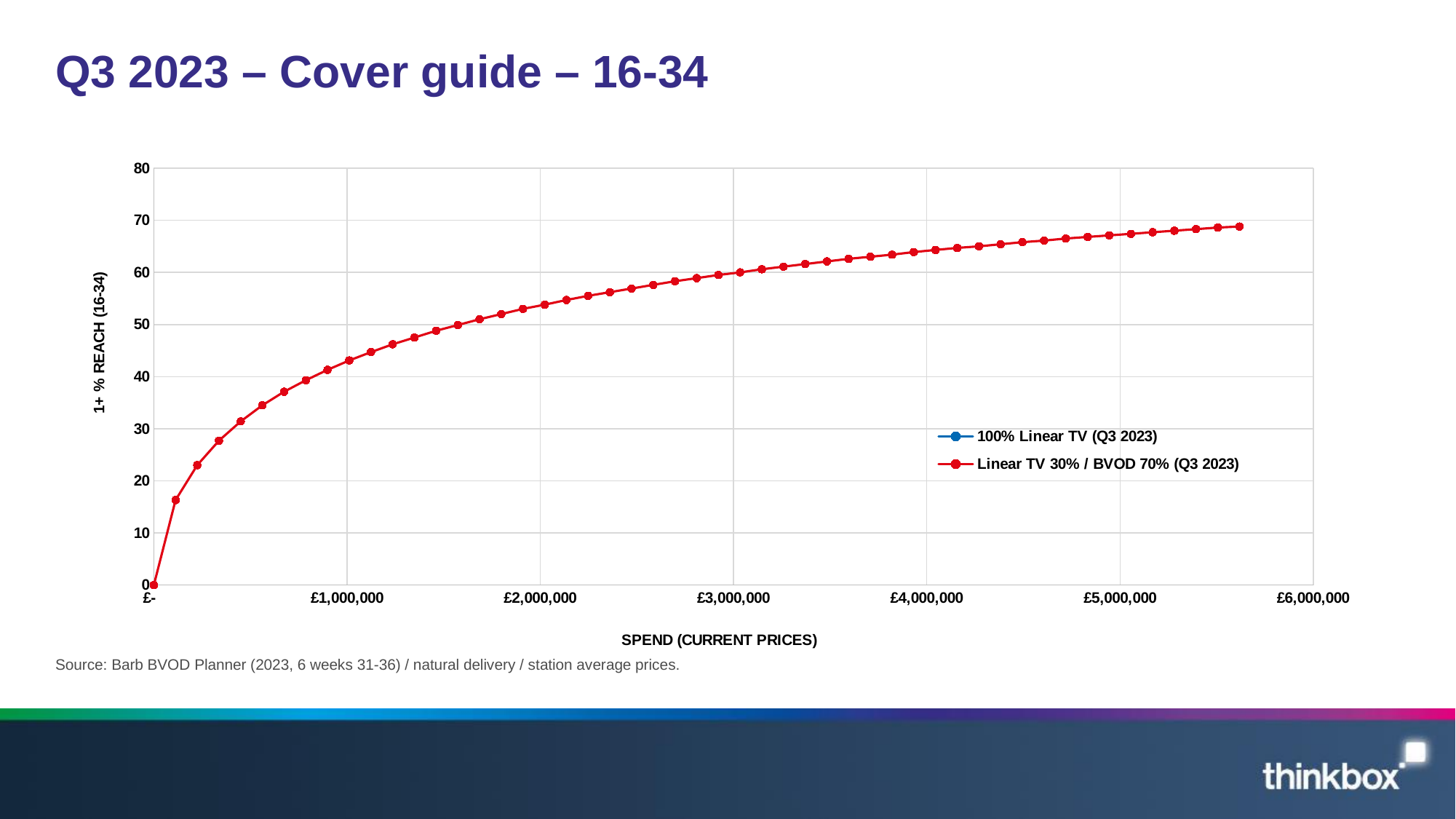
Is the 1+ % reach for the Linear TV 30% / BVOD 70% (Q3 2023) series at a spend of £1,000,000 greater or less than 40? greater What is the title of the y axis? 1+ % REACH (16-34) Does the 1+ % reach rise or fall as spend increases along the x axis? rise Is the 1+ % reach for the Linear TV 30% / BVOD 70% (Q3 2023) series at a spend of £4,000,000 greater or less than 70? less Is the 1+ % reach for the Linear TV 30% / BVOD 70% (Q3 2023) series at a spend of £5,000,000 greater or less than 70? less How many series does the legend list? 2 What colour is the line for the Linear TV 30% / BVOD 70% (Q3 2023) series? red What is the 1+ % reach value for the Linear TV 30% / BVOD 70% (Q3 2023) series at a spend of £-? 0 What kind of chart is shown on the slide? line chart